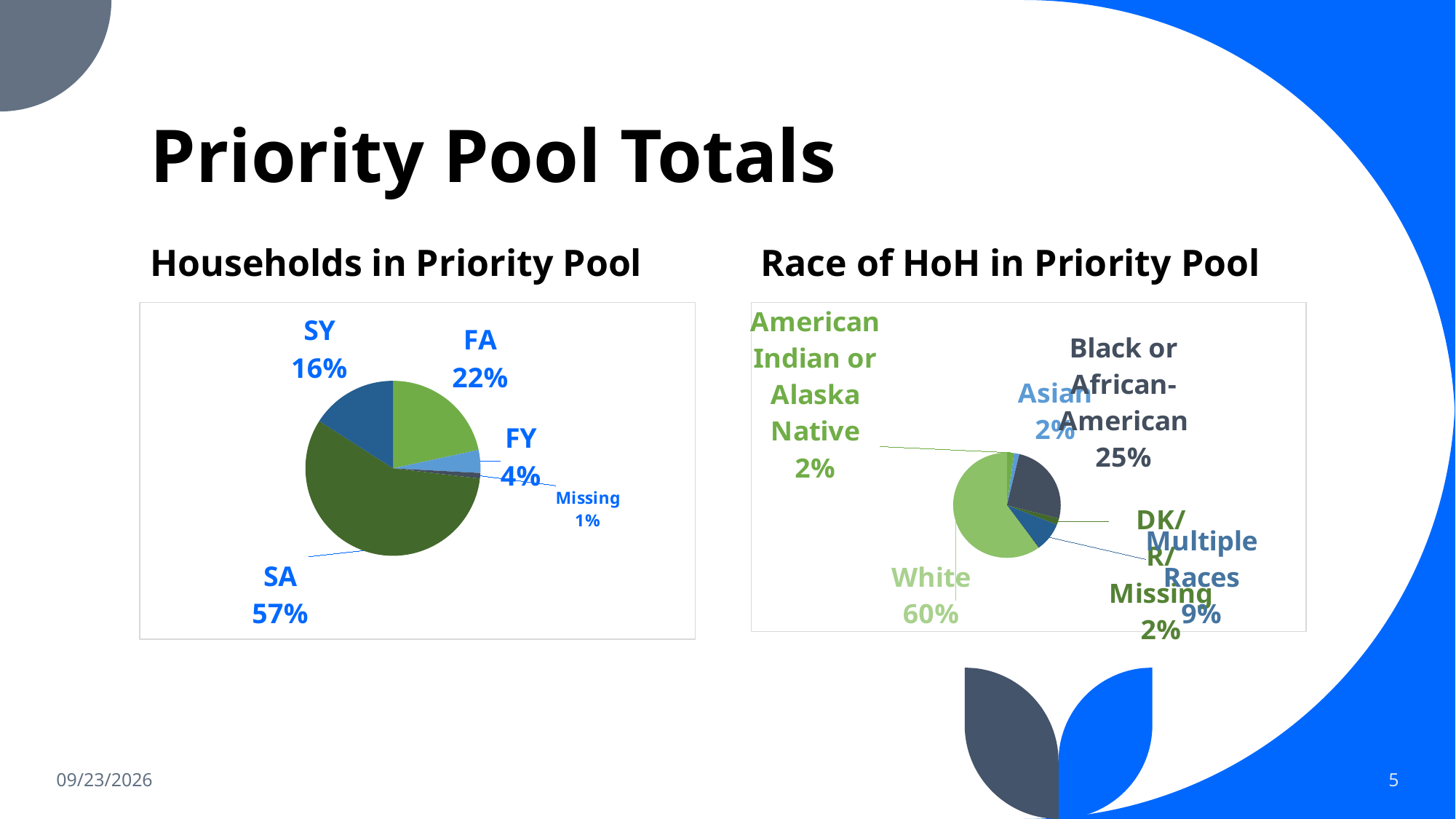
In the Households in Priority Pool chart, how many categories are shown? 5 In the Households in Priority Pool chart, what share is SA? 57% In the Households in Priority Pool chart, what is the difference between the SY and FY shares? 12% In the Households in Priority Pool chart, which category has the smallest share? Missing In the Race of HoH in Priority Pool chart, which category has the largest share? White In the Race of HoH in Priority Pool chart, what share is White? 60% What kind of chart is the Households in Priority Pool chart? Pie chart In the Households in Priority Pool chart, what share is FA? 22% In the Households in Priority Pool chart, which category has the largest share? SA In the Race of HoH in Priority Pool chart, what share is Black or African-American? 25% In the Race of HoH in Priority Pool chart, what is the difference between the White and Black or African-American shares? 35% In the Race of HoH in Priority Pool chart, which is larger, Multiple Races or Asian? Multiple Races